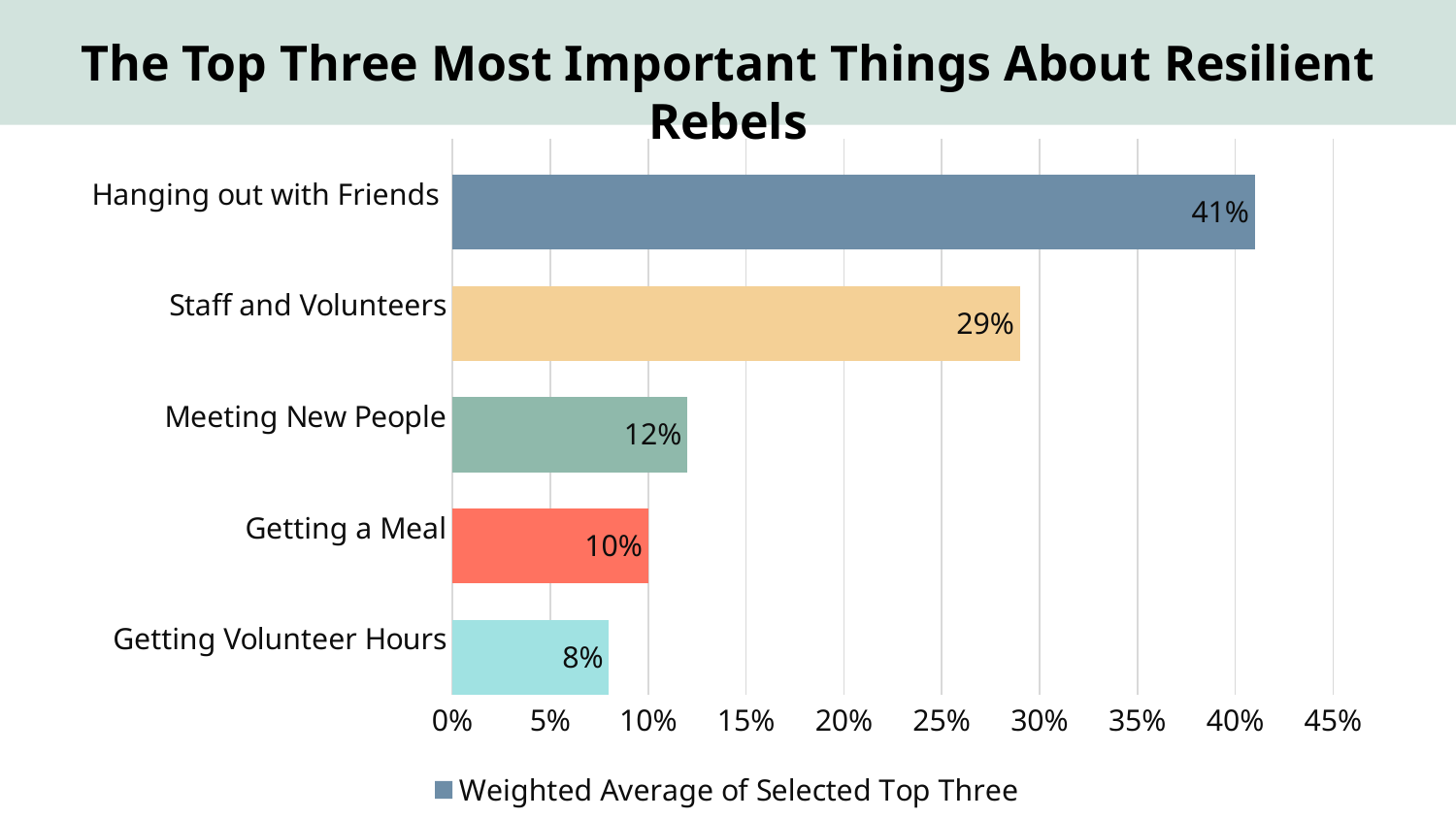
What is the difference between the values for Hanging out with Friends and Staff and Volunteers? 12% What series name does the legend show? Weighted Average of Selected Top Three What is the difference between the values for Meeting New People and Getting a Meal? 2% Which is larger, the value for Meeting New People or the value for Getting Volunteer Hours? Meeting New People How many categories are shown in the chart? 5 What kind of chart is shown on the slide? Bar chart Which category has the lowest value? Getting Volunteer Hours Is the value for Staff and Volunteers greater or less than 25%? greater What is the value for Getting Volunteer Hours? 8% Which category has the highest value? Hanging out with Friends What is the value for Hanging out with Friends? 41% What is the value for Staff and Volunteers? 29%